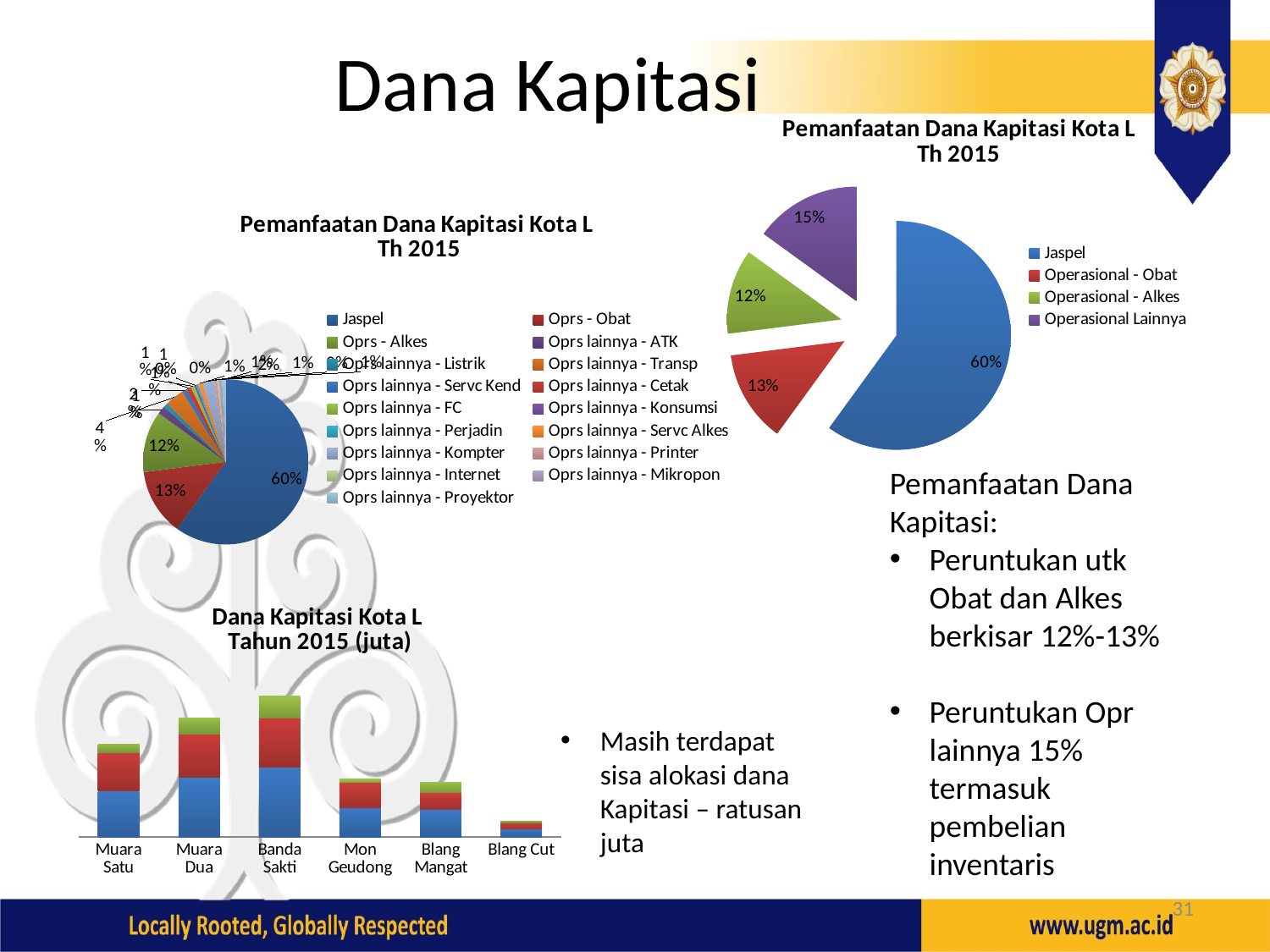
In the left pie chart, what share does Oprs - Obat have? 13% In the top-right pie chart, what share does Operasional Lainnya have? 15% In the 'Dana Kapitasi Kota L Tahun 2015 (juta)' chart, which category has the tallest bar? Banda Sakti How many entries does the legend of the top-right pie chart list? 4 In the top-right pie chart, what share does Operasional - Obat have? 13% In the top-right pie chart, which category has the smallest share? Operasional - Alkes In the top-right pie chart, which category has the largest share? Jaspel In the top-right pie chart, what is the difference between the Jaspel share and the Operasional Lainnya share? 45% How many categories are shown in the 'Dana Kapitasi Kota L Tahun 2015 (juta)' chart? 6 What kind of chart is 'Dana Kapitasi Kota L Tahun 2015 (juta)'? Bar chart In the top-right pie chart, what share does Jaspel have? 60% In the top-right pie chart, what share does Operasional - Alkes have? 12%